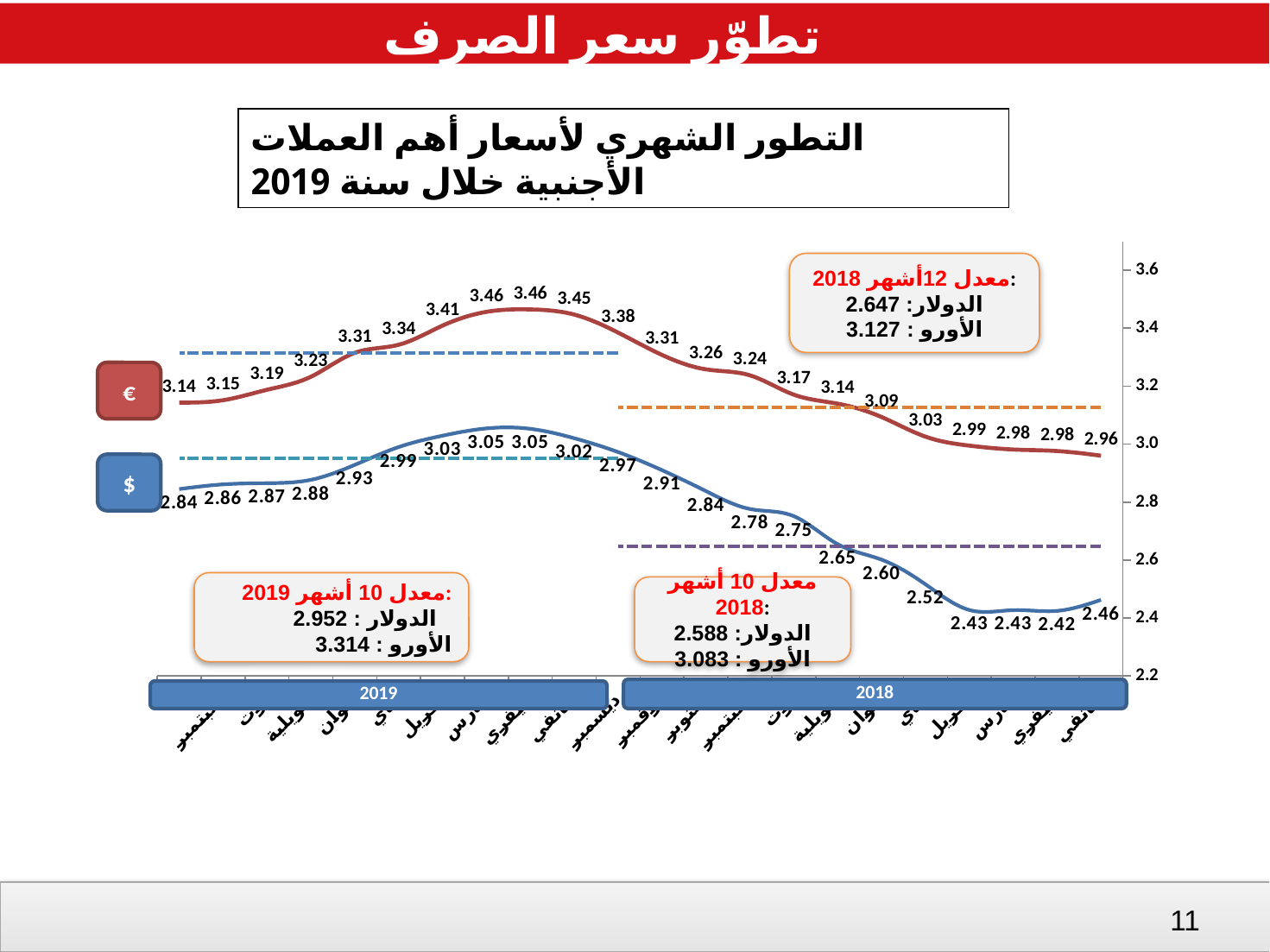
How many monthly data points does each line have in total across 2018 and 2019? 22 What is the highest value labelled on the euro (€) line? 3.46 What is the lowest value labelled on the dollar ($) line? 2.42 Over 2018, does the dollar ($) rate rise or fall from January to December? rise What is the dollar value labelled at the rightmost point of the chart (January 2018)? 2.46 Which line is higher throughout the chart, the euro (€) line or the dollar ($) line? euro (€) What kind of chart is shown on the slide? line chart What is the difference between the highest euro value (3.46) and the highest dollar value (3.05)? 0.41 According to the annotation box, what is the 12-month 2018 average for the dollar? 2.647 What is the highest value labelled on the dollar ($) line? 3.05 What is the lowest value labelled on the euro (€) line? 2.96